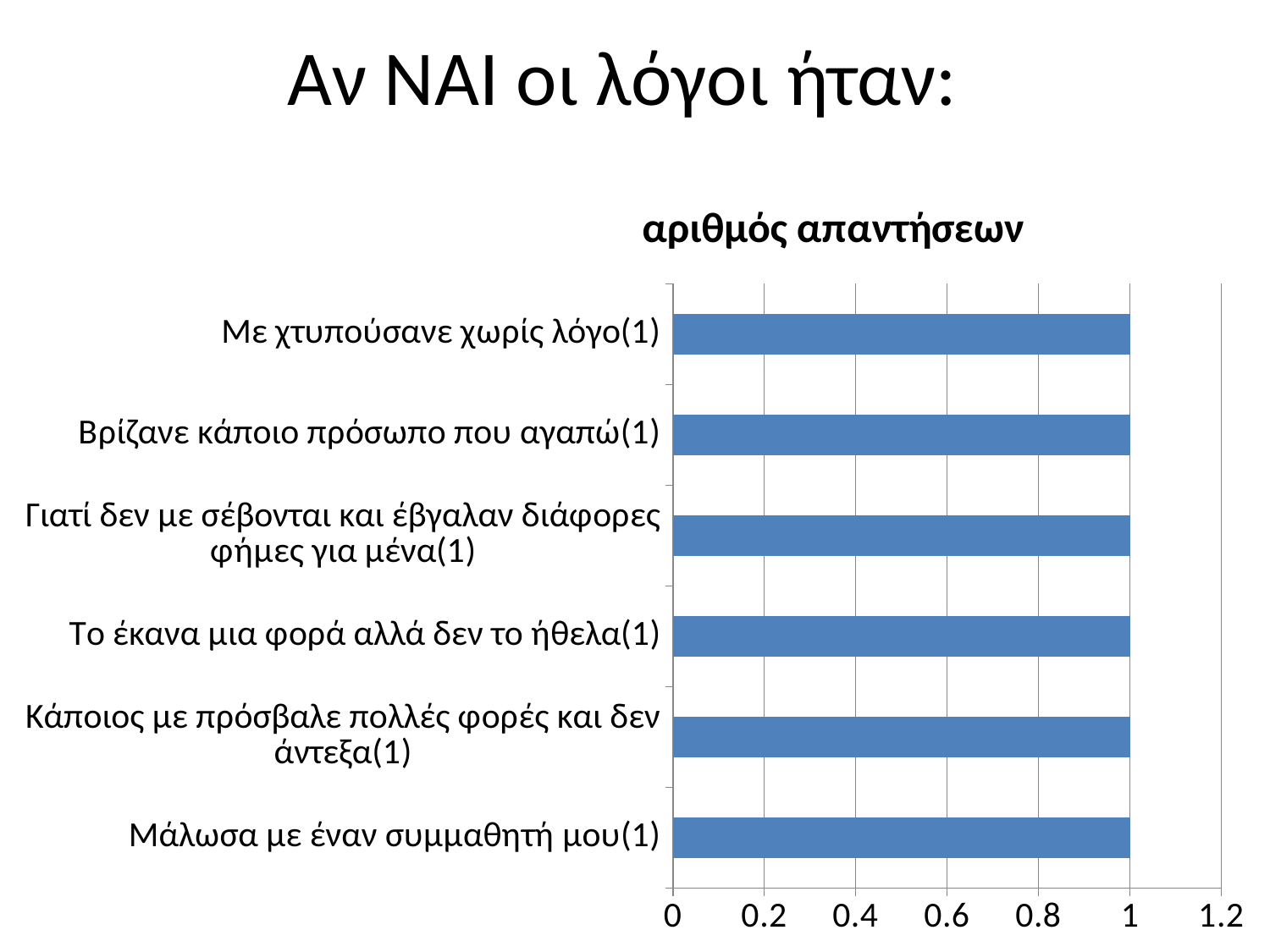
What is the value for "Βρίζανε κάποιο πρόσωπο που αγαπώ(1)"? 1 What is the difference between the values for "Με χτυπούσανε χωρίς λόγο(1)" and "Μάλωσα με έναν συμμαθητή μου(1)"? 0 What is the value for "Μάλωσα με έναν συμμαθητή μου(1)"? 1 What is the title of the chart? αριθμός απαντήσεων What is the value for "Με χτυπούσανε χωρίς λόγο(1)"? 1 What is the highest value shown on the x axis? 1.2 Is the value for "Κάποιος με πρόσβαλε πολλές φορές και δεν άντεξα(1)" greater or less than 0.8? greater What is the value for "Το έκανα μια φορά αλλά δεν το ήθελα(1)"? 1 What kind of chart is shown on the slide? bar chart Is the value for "Γιατί δεν με σέβονται και έβγαλαν διάφορες φήμες για μένα(1)" greater or less than 1.2? less How many categories (reasons) are plotted in the chart? 6